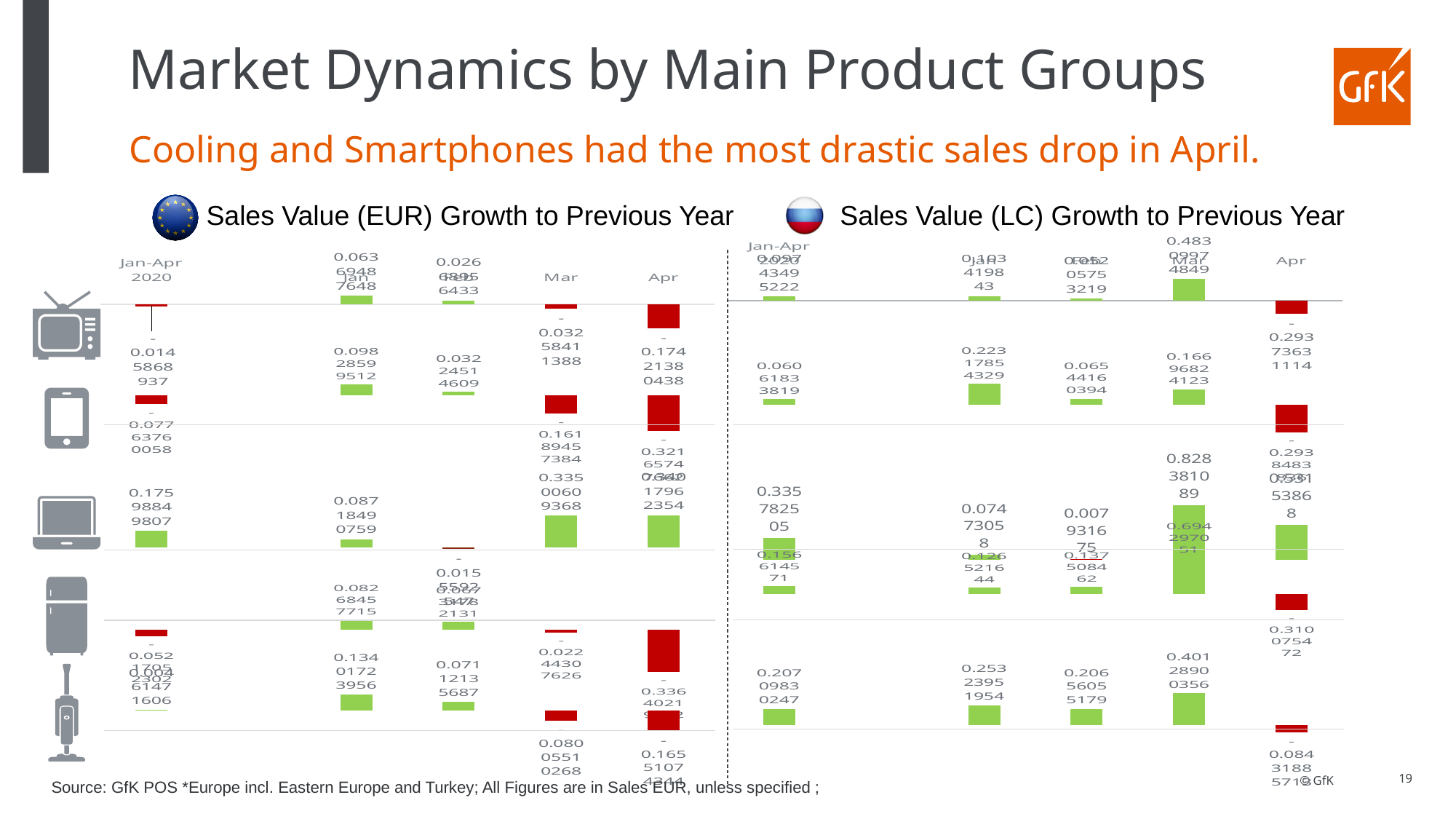
In the Sales Value (LC) Growth to Previous Year chart, which month is the only one with a negative bar in the vacuum cleaner row? Apr In the Sales Value (EUR) Growth to Previous Year chart, which is larger for the vacuum cleaner row: the January bar or the February bar? January How many time periods (columns) are shown for each product group in the Sales Value (EUR) Growth to Previous Year chart? 5 In the Sales Value (LC) Growth to Previous Year chart, is the March bar for the cooling (refrigerator) row larger or smaller than the February bar? Larger In the Sales Value (EUR) Growth to Previous Year chart, is the April bar for the TV row positive or negative? Negative What kind of chart is used on the slide to show sales value growth? Bar chart In the Sales Value (EUR) Growth to Previous Year chart, is the laptop row's March bar positive or negative? Positive In the Sales Value (LC) Growth to Previous Year chart, do the vacuum cleaner bars rise or fall from March to April? Fall How many product groups (rows) are shown in the Sales Value (LC) Growth to Previous Year chart? 5 In the Sales Value (LC) Growth to Previous Year chart, which month has the tallest bar in the laptop row? Mar In the Sales Value (EUR) Growth to Previous Year chart, which product group has the largest April decline: TV or smartphones? Smartphones